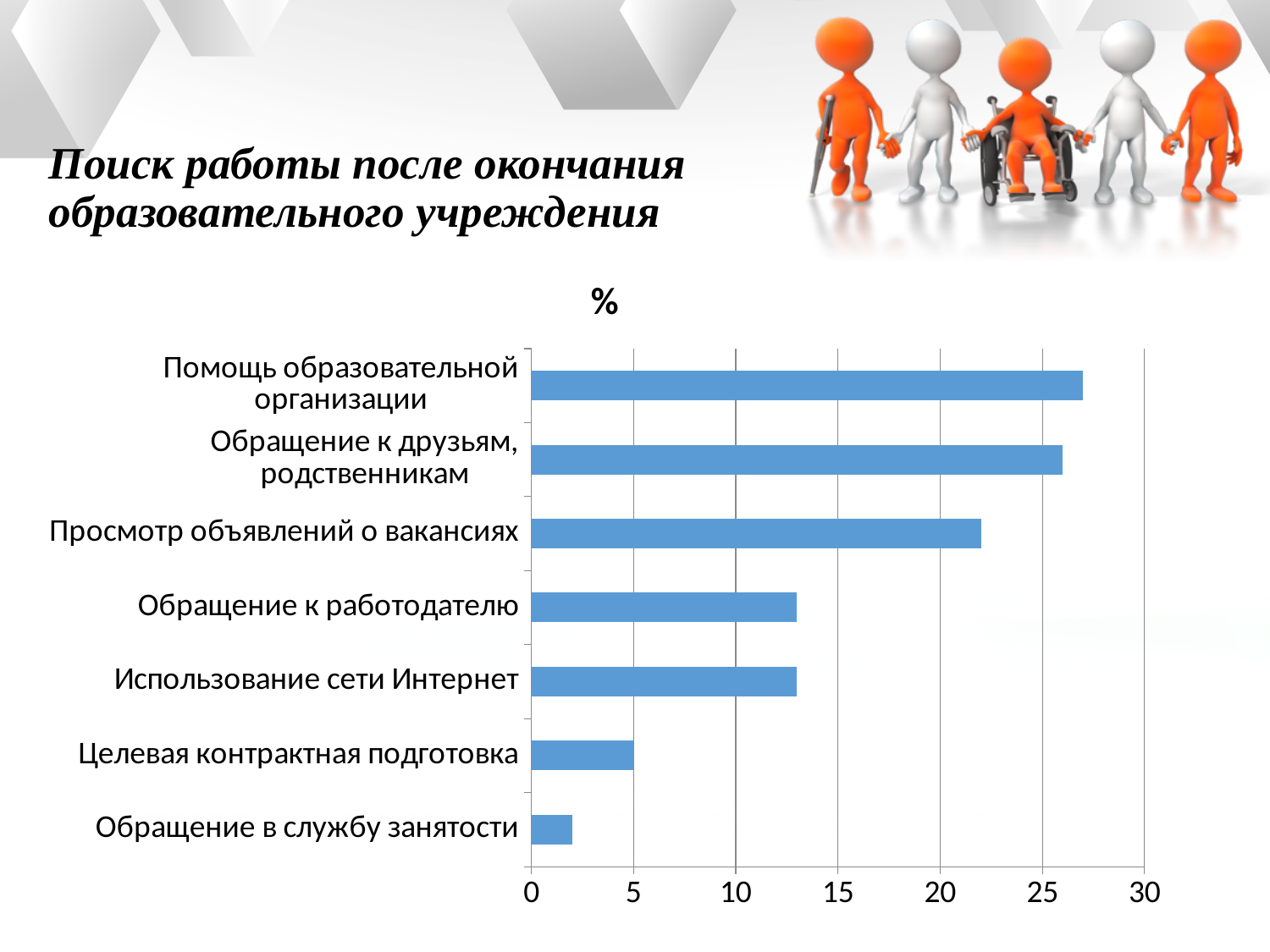
How many categories are plotted in the chart? 7 Is the value for Обращение к работодателю greater or less than 15? less Which is larger: the value for Просмотр объявлений о вакансиях or the value for Обращение к работодателю? Просмотр объявлений о вакансиях Is the value for Целевая контрактная подготовка greater or less than 10? less Is the value for Обращение в службу занятости greater or less than 5? less What is the title of the chart? % Which category has the lowest value in the chart? Обращение в службу занятости What kind of chart is shown on the slide? bar chart